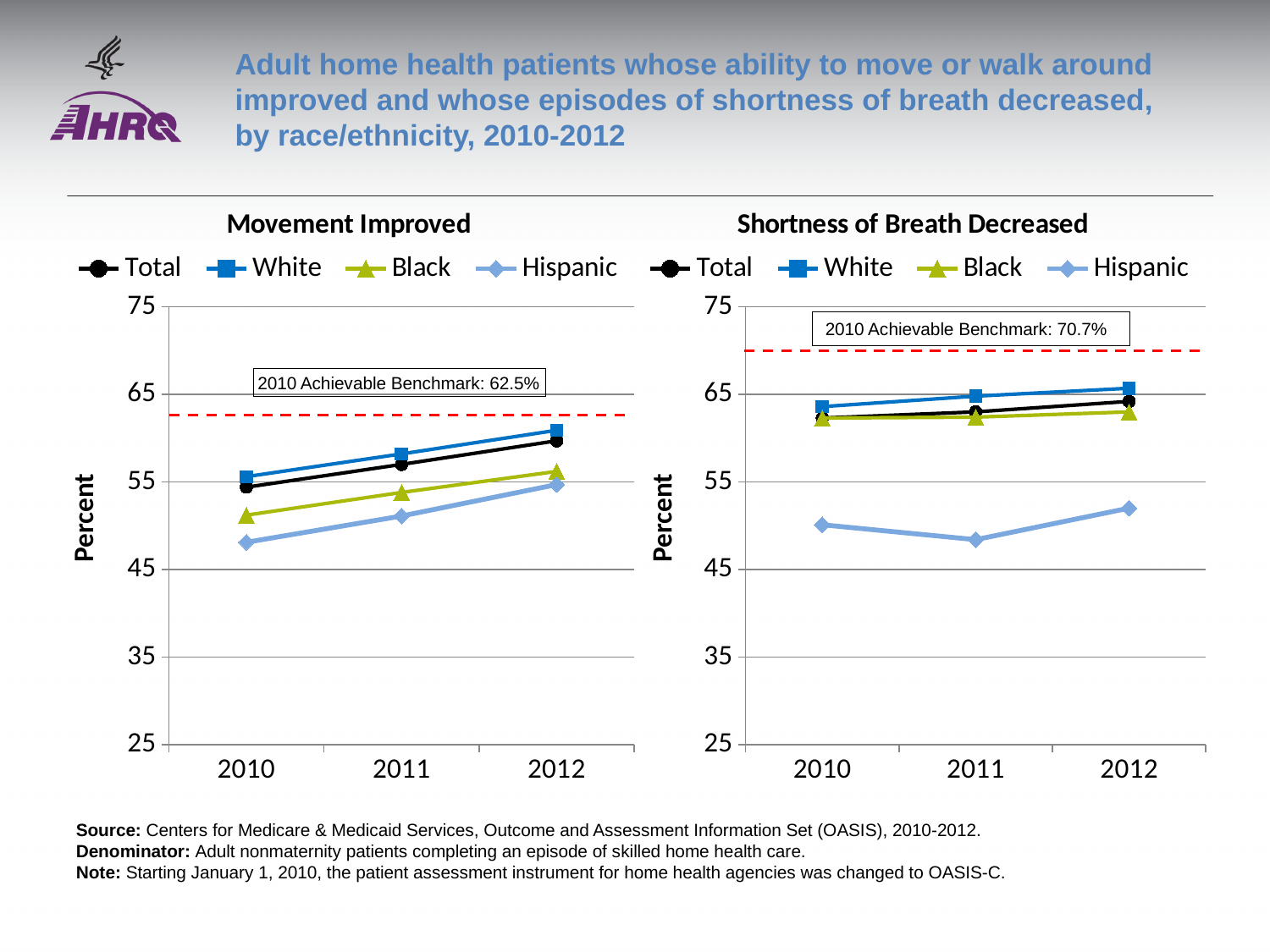
In the Shortness of Breath Decreased chart, which is larger in 2010, the value for White or the value for Hispanic? White In the Movement Improved chart, which group has the lowest value in 2010? Hispanic In the Movement Improved chart, is the value for Hispanic in 2010 greater or less than 55? less In the Shortness of Breath Decreased chart, is the value for Hispanic in 2011 greater or less than 55? less In the Shortness of Breath Decreased chart, what is the 2010 Achievable Benchmark shown? 70.7% In the Shortness of Breath Decreased chart, which group has the lowest value in 2012? Hispanic What kind of chart is the Movement Improved chart? line chart How many years are plotted on the x axis of the Movement Improved chart? 3 In the Movement Improved chart, does the White series rise or fall from 2010 to 2012? rise How many series does the legend of the Shortness of Breath Decreased chart list? 4 In the Movement Improved chart, what is the 2010 Achievable Benchmark shown? 62.5% In the Movement Improved chart, which group has the highest value in 2012? White